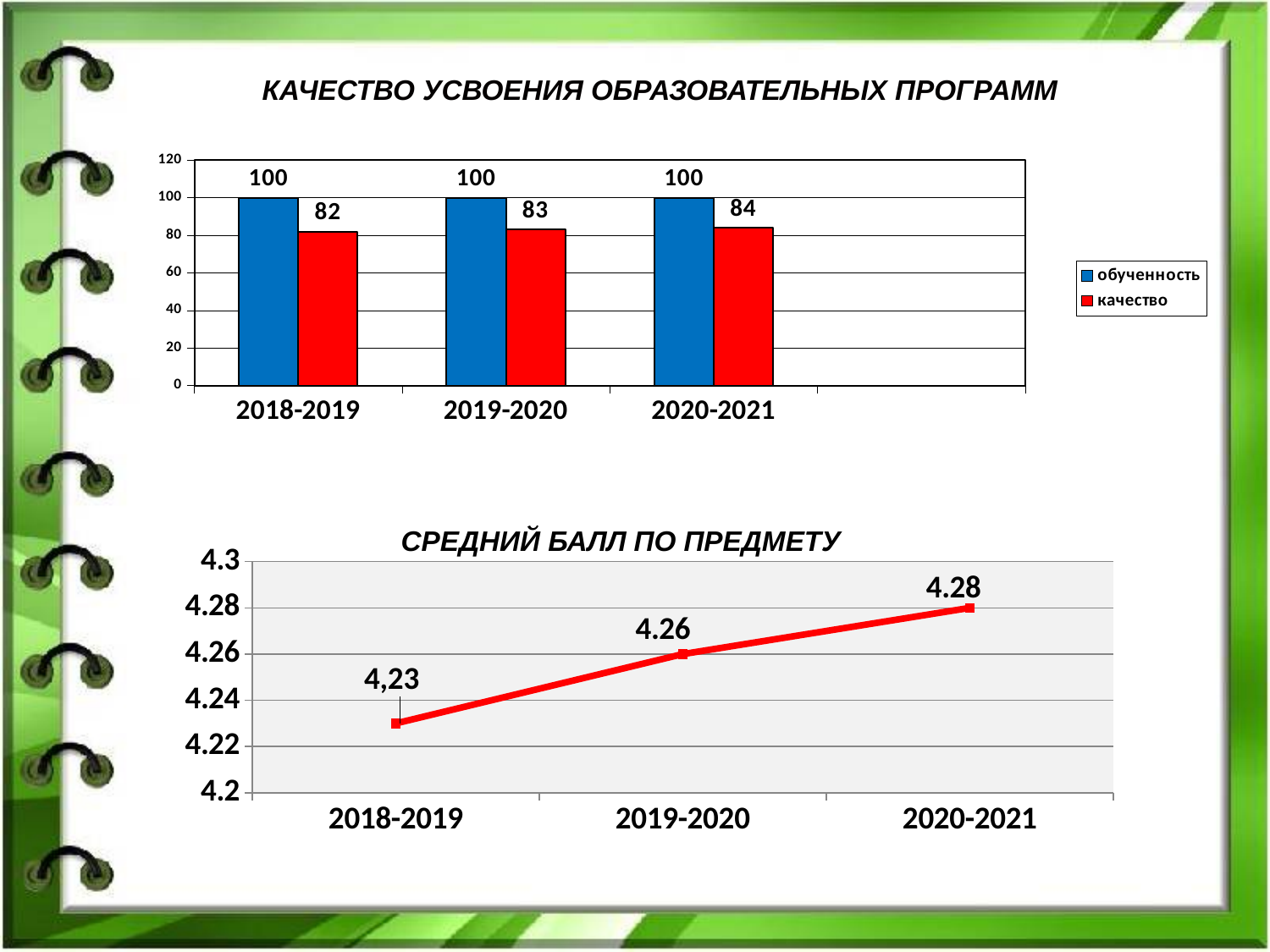
In the top chart (КАЧЕСТВО УСВОЕНИЯ ОБРАЗОВАТЕЛЬНЫХ ПРОГРАММ), how many series does the legend list? 2 In the top chart (КАЧЕСТВО УСВОЕНИЯ ОБРАЗОВАТЕЛЬНЫХ ПРОГРАММ), what is the value of качество for 2019-2020? 83 In the top chart (КАЧЕСТВО УСВОЕНИЯ ОБРАЗОВАТЕЛЬНЫХ ПРОГРАММ), what is the value of обученность for 2018-2019? 100 In the top chart (КАЧЕСТВО УСВОЕНИЯ ОБРАЗОВАТЕЛЬНЫХ ПРОГРАММ), which year has the highest качество value? 2020-2021 In the top chart (КАЧЕСТВО УСВОЕНИЯ ОБРАЗОВАТЕЛЬНЫХ ПРОГРАММ), what kind of chart is shown? Bar chart In the top chart (КАЧЕСТВО УСВОЕНИЯ ОБРАЗОВАТЕЛЬНЫХ ПРОГРАММ), what is the difference between обученность and качество in 2020-2021? 16 In the bottom chart (СРЕДНИЙ БАЛЛ ПО ПРЕДМЕТУ), do the values rise or fall from 2018-2019 to 2020-2021? Rise In the bottom chart (СРЕДНИЙ БАЛЛ ПО ПРЕДМЕТУ), which year has the highest value? 2020-2021 In the top chart (КАЧЕСТВО УСВОЕНИЯ ОБРАЗОВАТЕЛЬНЫХ ПРОГРАММ), which colour represents качество? Red In the bottom chart (СРЕДНИЙ БАЛЛ ПО ПРЕДМЕТУ), what is the value for 2019-2020? 4.26 In the bottom chart (СРЕДНИЙ БАЛЛ ПО ПРЕДМЕТУ), how many data points are plotted? 3 In the top chart (КАЧЕСТВО УСВОЕНИЯ ОБРАЗОВАТЕЛЬНЫХ ПРОГРАММ), which year has the lowest качество value? 2018-2019